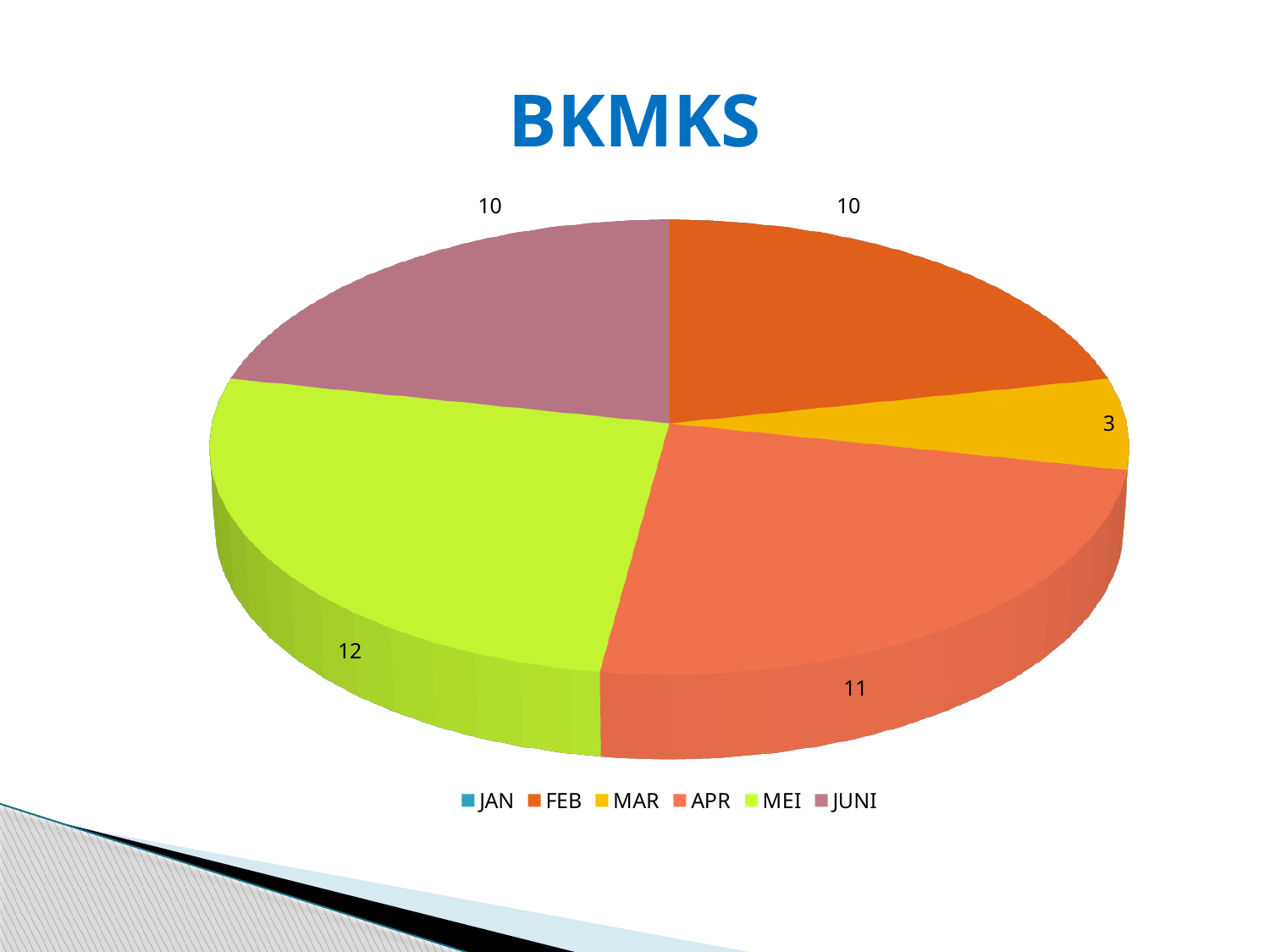
What is the value for FEB? 10 What is the difference between the values for MEI and MAR? 9 Which category has the largest slice of the pie? MEI What is the title of the chart? BKMKS What is the value for APR? 11 What kind of chart is shown on the slide? pie chart What is the value for MAR? 3 Which is larger, the value for APR or the value for FEB? APR What is the value for MEI? 12 Which category has the smallest visible slice of the pie? MAR What is the value for JUNI? 10 How many categories does the legend list? 6